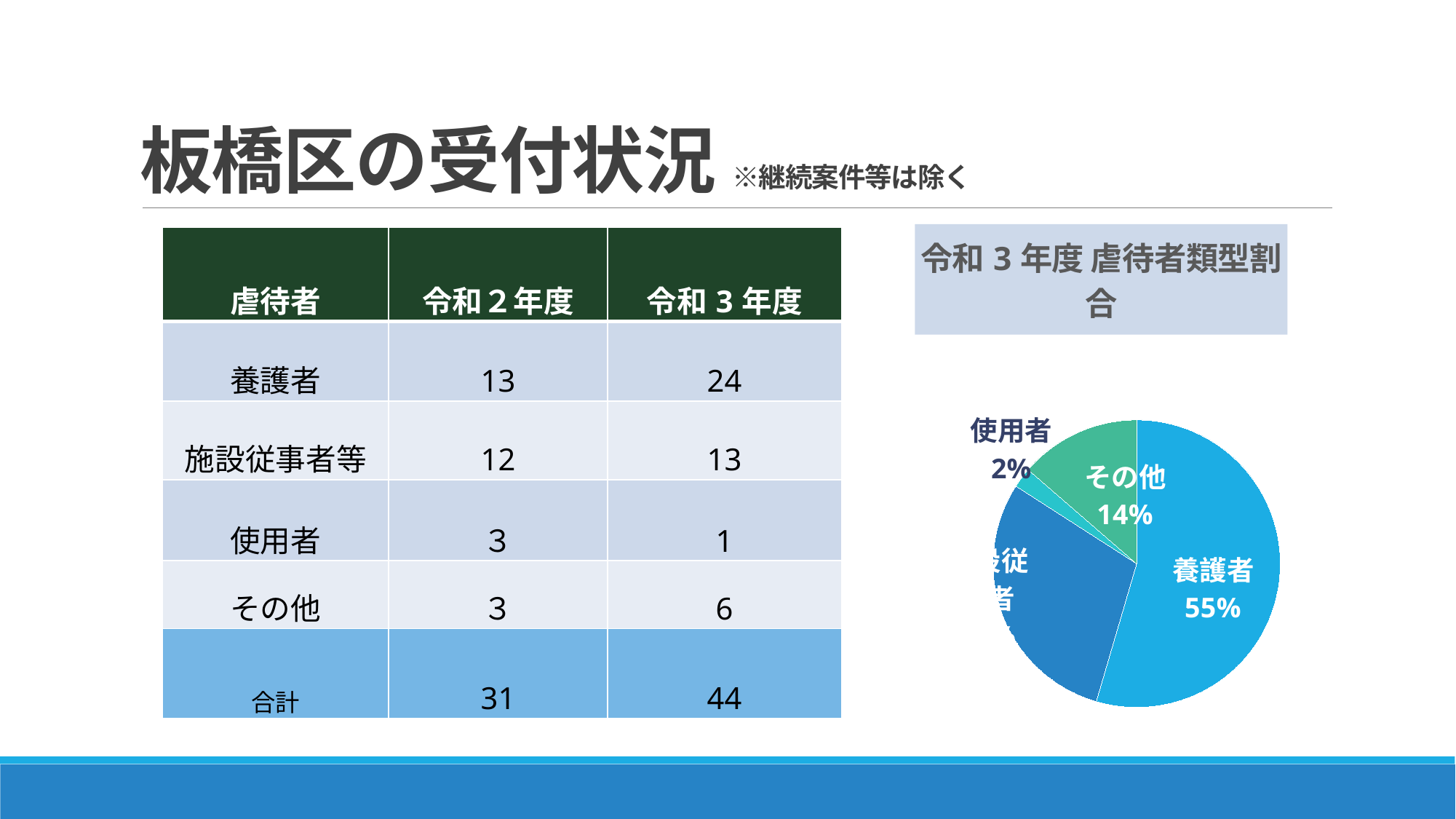
How many slices does the pie chart have? 4 What is the title of the pie chart? 令和３年度 虐待者類型割合 In the pie chart, how many percentage points larger is 養護者 than その他? 41% In the pie chart, how many percentage points larger is その他 than 使用者? 12% In the pie chart, which is larger, 養護者 or その他? 養護者 What kind of chart is shown on the right side of the slide? pie chart In the pie chart, what share does 養護者 have? 55% In the pie chart, what share does 使用者 have? 2% Which slice of the pie chart is the largest? 養護者 In the pie chart, which is larger, その他 or 使用者? その他 Which slice of the pie chart is the smallest? 使用者 In the pie chart, what share does その他 have? 14%